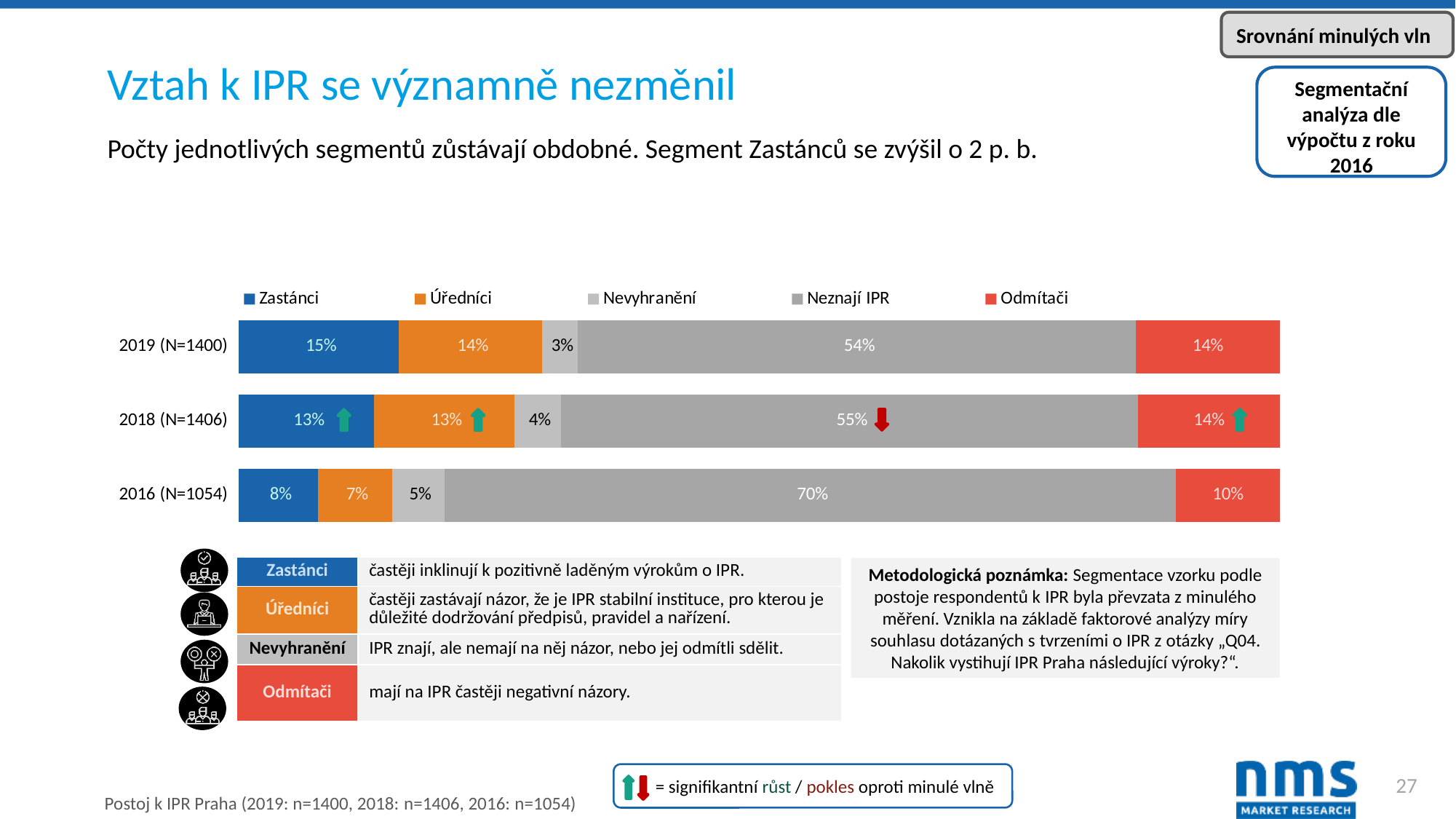
Which series is shown in orange in the legend? Úředníci Which year has the lowest value for Zastánci? 2016 (N=1054) Which is larger: the Úředníci value in 2019 or in 2016? 2019 What is the value for Nevyhranění in 2018 (N=1406)? 4% Which year has the highest value for Neznají IPR? 2016 (N=1054) What is the value for Neznají IPR in 2016 (N=1054)? 70% How many bars (years) are shown in the chart? 3 What is the difference between the Neznají IPR value in 2016 and in 2019? 16% What type of chart is shown on the slide? stacked bar chart What is the value for Zastánci in 2019 (N=1400)? 15% How many series does the chart legend list? 5 What is the value for Odmítači in 2019 (N=1400)? 14%